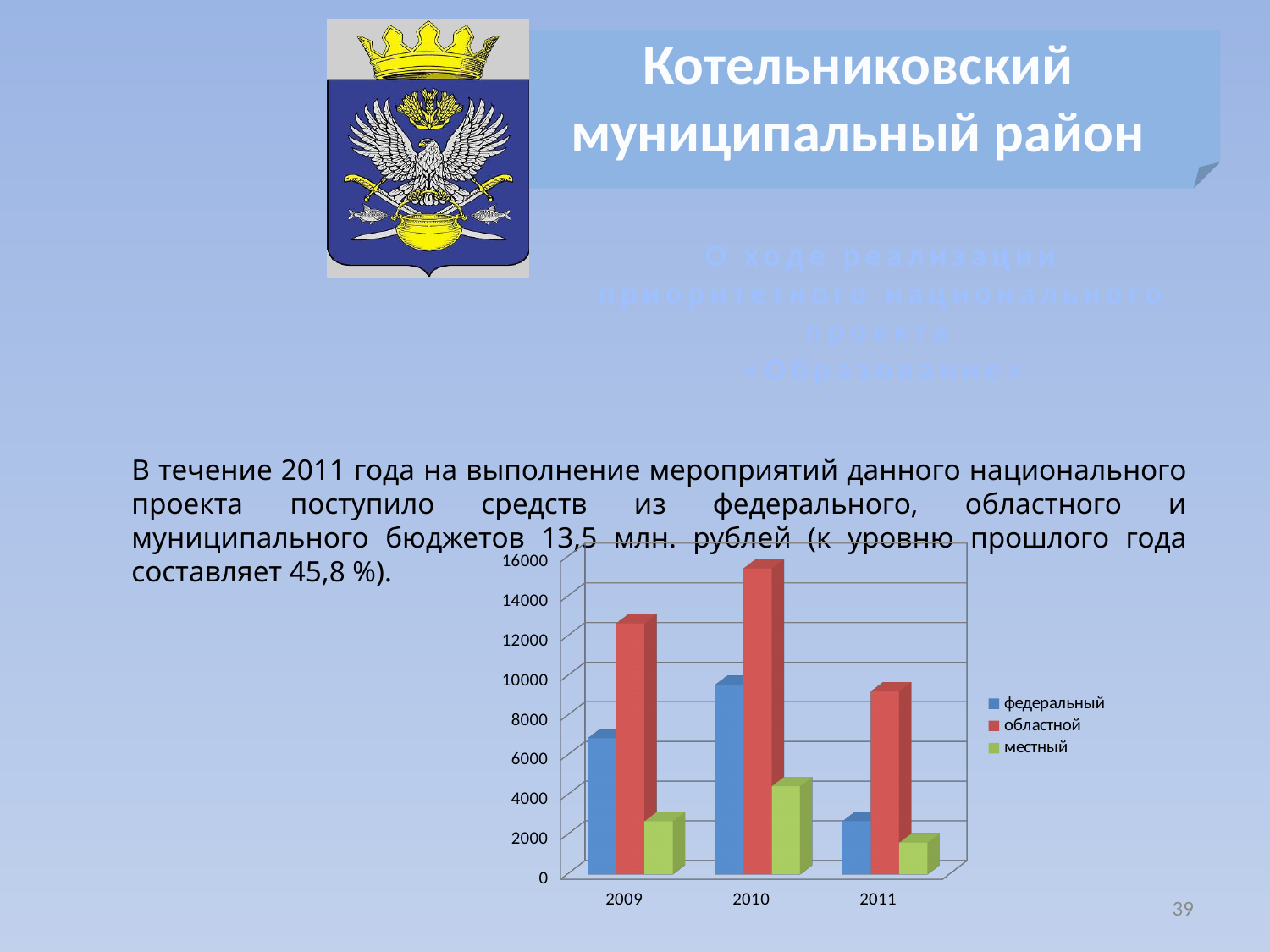
Which series is shown in green in the chart? местный Which is larger in 2009: the федеральный value or the областной value? областной Is the value for областной in 2010 greater or less than 14000? greater Which year has the highest value for the областной series? 2010 How many series does the chart legend list? 3 Which year has the lowest value for the федеральный series? 2011 What kind of chart is shown on the slide? bar chart How many years are shown on the x axis of the chart? 3 Which series is shown in red in the chart? областной Is the value for местный in 2009 greater or less than 4000? less Which year has the highest value for the местный series? 2010 Is the value for федеральный in 2011 greater or less than 4000? less